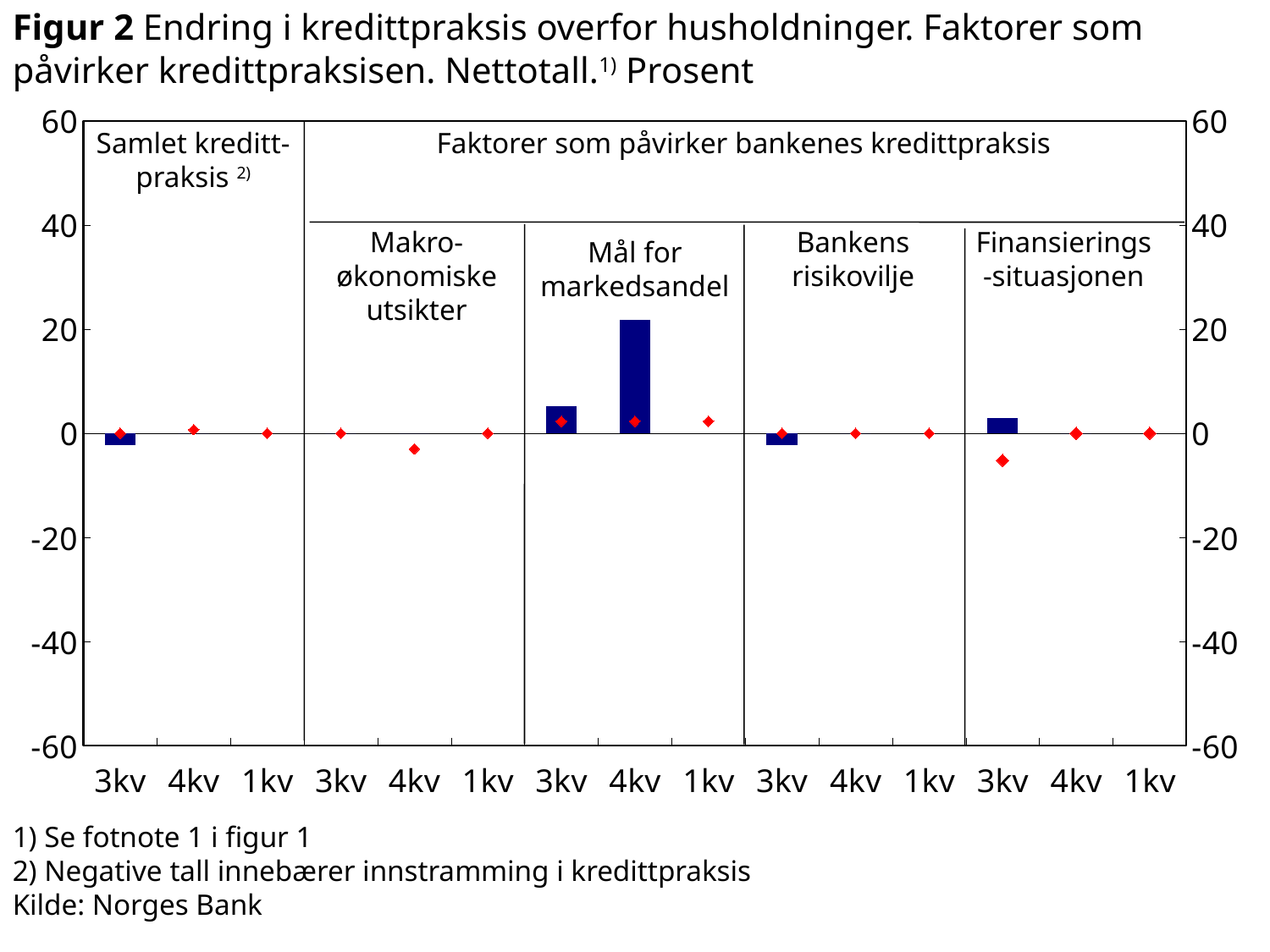
Is the bar for 3kv in the "Samlet kredittpraksis" panel greater or less than 0? less What kind of chart is shown on the slide? bar chart What is the highest value shown on the vertical axis? 60 What source is cited for the chart? Norges Bank In which panel and quarter is the tallest bar found? Mål for markedsandel, 4kv Is the bar for 3kv in the "Bankens risikovilje" panel greater or less than 0? less Is the bar for 4kv in the "Mål for markedsandel" panel greater or less than 40? less In the "Mål for markedsandel" panel, do the bars rise or fall from 3kv to 4kv? rise How many factor panels are shown under "Faktorer som påvirker bankenes kredittpraksis"? 4 How many quarter labels (3kv, 4kv, 1kv) appear along the x axis in total? 15 In the "Mål for markedsandel" panel, which bar is larger: 3kv or 4kv? 4kv